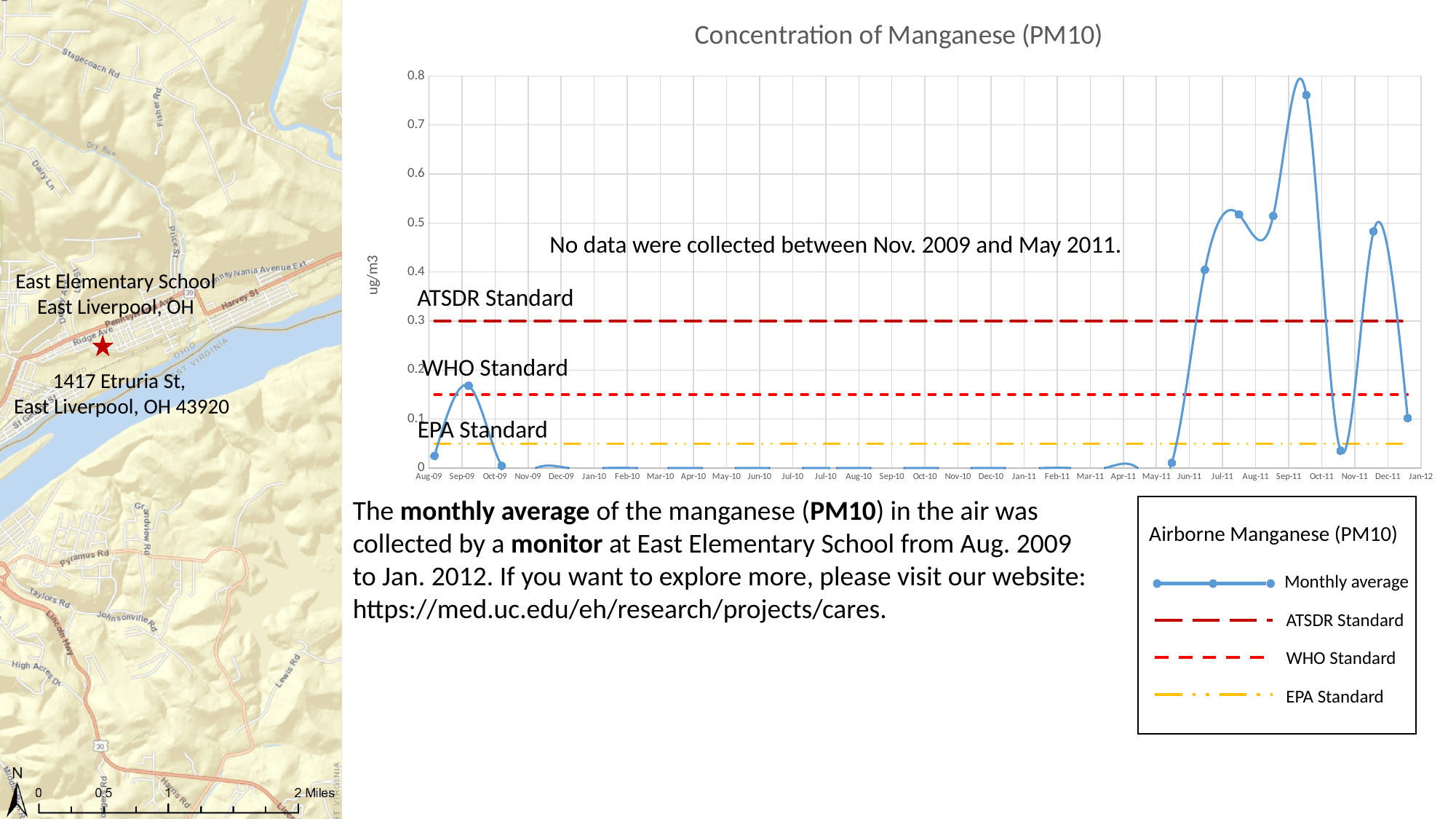
Is the WHO Standard greater or less than 0.2? less What is the title of the chart? Concentration of Manganese (PM10) Which of the three standard lines is the highest? ATSDR Standard Is the highest monthly average value on the chart greater or less than 0.7? greater How many entries does the chart legend list? 4 What value does the ATSDR Standard line sit at on the y axis? 0.3 Is the monthly average for Sep-09 greater or less than 0.3? less What unit is shown on the y axis of the chart? ug/m3 Which of the three standard lines is the lowest? EPA Standard Which is higher, the ATSDR Standard or the WHO Standard? ATSDR Standard What type of chart is shown on the slide? line chart